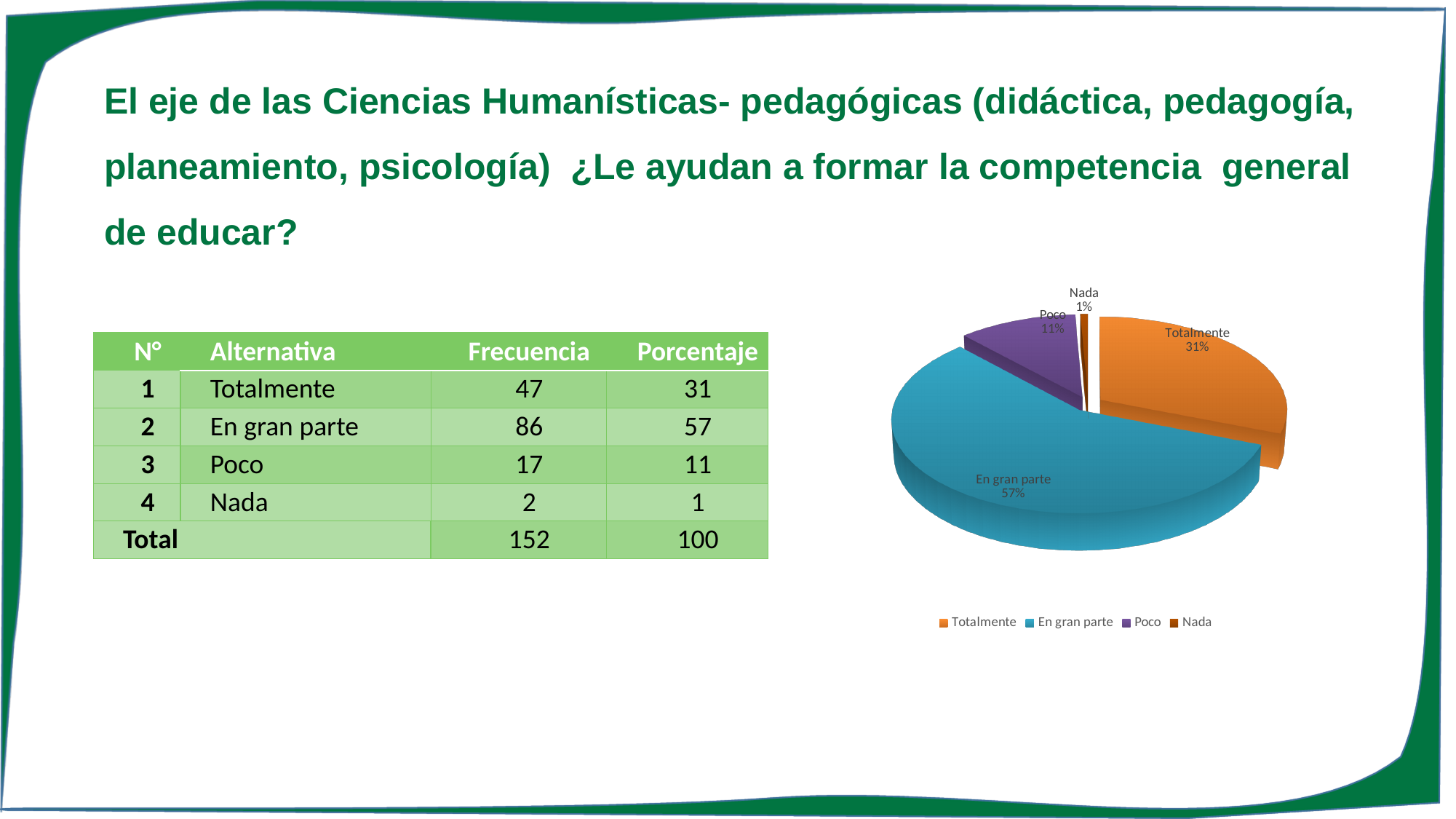
How many entries does the pie chart legend list? 4 What percentage does the pie chart show for "En gran parte"? 57% What colour is the "En gran parte" slice in the pie chart? blue What kind of chart is shown on the slide? pie chart What percentage does the pie chart show for "Poco"? 11% Which category has the smallest slice in the pie chart? Nada How many slices does the pie chart have? 4 Which category has the largest slice in the pie chart? En gran parte What percentage does the pie chart show for "Nada"? 1% Which slice is larger in the pie chart, "Poco" or "Totalmente"? Totalmente What percentage does the pie chart show for "Totalmente"? 31% What is the difference in percentage points between "En gran parte" and "Totalmente" in the pie chart? 26